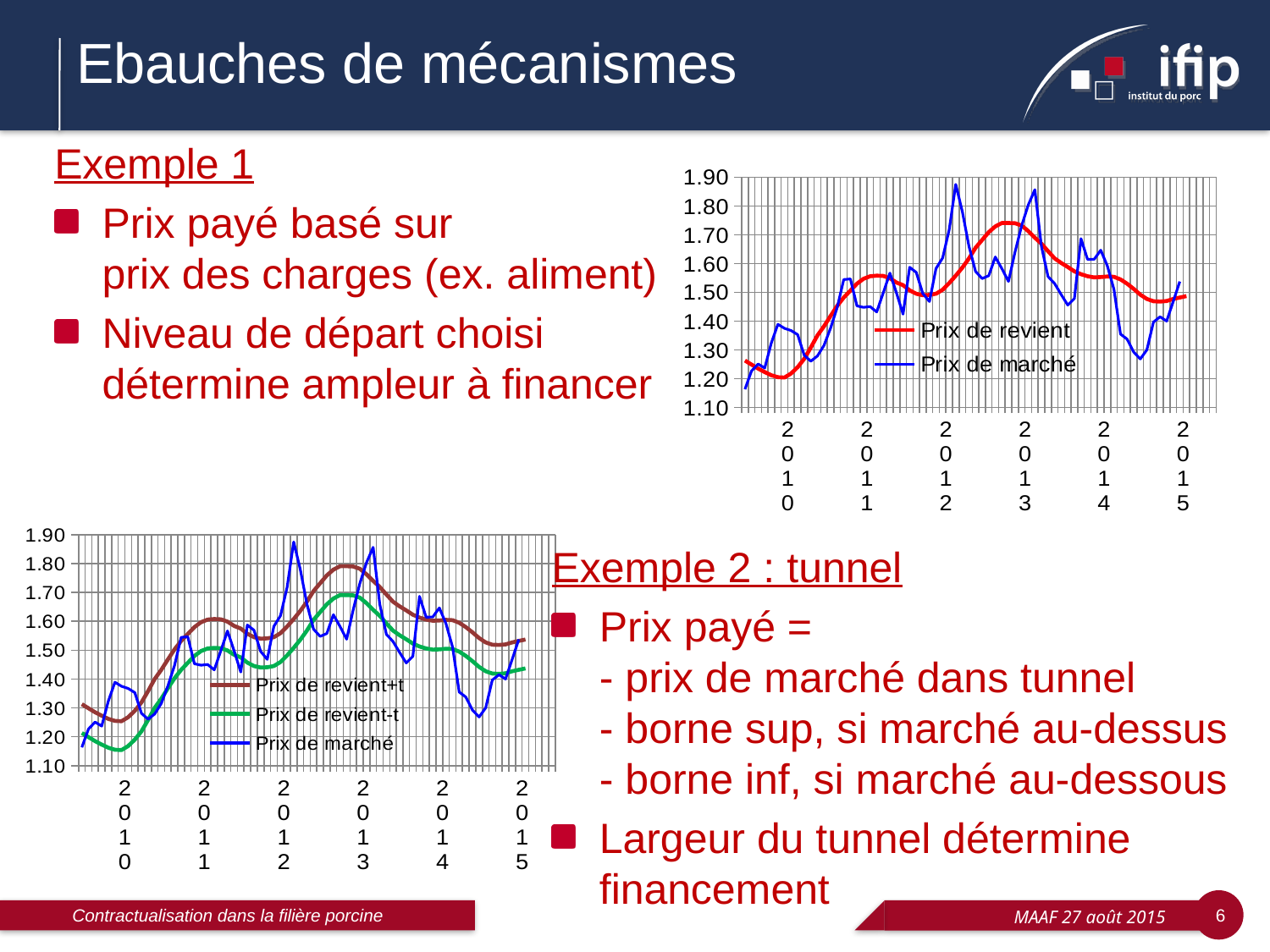
In the top-right chart, which series reaches the higher maximum value, Prix de revient or Prix de marché? Prix de marché How many series does the legend of the top-right chart list? 2 In the bottom-left chart, is the peak value of Prix de revient+t greater or less than 1.70? greater In the bottom-left chart, which line lies higher, Prix de revient+t or Prix de revient-t? Prix de revient+t In the top-right chart, which series is drawn in red? Prix de revient In the top-right chart, is the highest value of Prix de revient greater or less than 1.70? greater What kind of chart is the top-right chart on the slide? line chart How many series does the legend of the bottom-left chart list? 3 In the top-right chart, is the first value of Prix de marché in 2010 greater or less than 1.20? less In the top-right chart, does Prix de revient rise or fall between 2010 and 2013? rise In the bottom-left chart, which series is drawn in green? Prix de revient-t